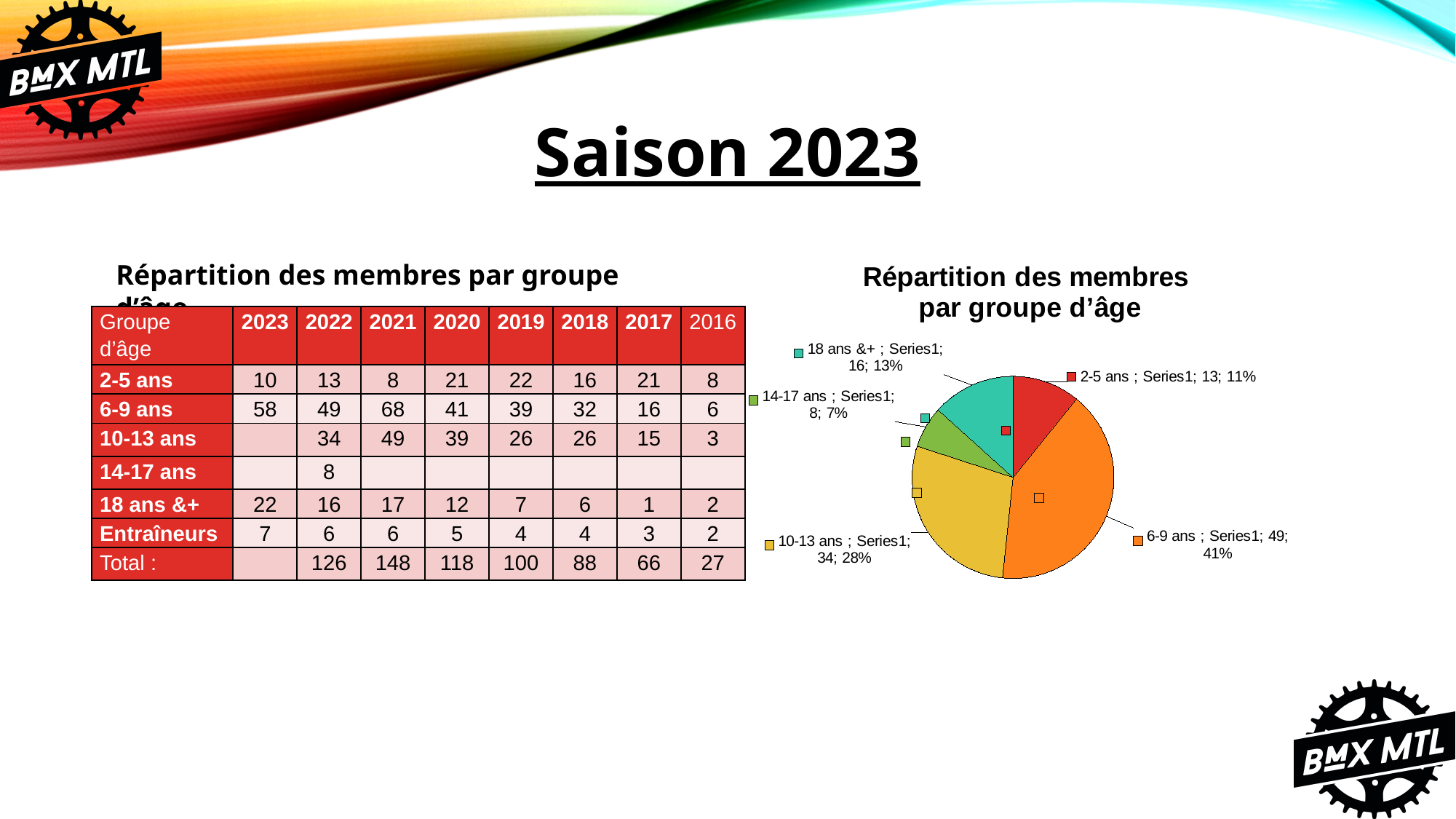
What share of the pie does 14-17 ans represent? 7% How many slices does the pie chart have? 5 Which is larger in the pie chart, 18 ans &+ or 2-5 ans? 18 ans &+ What is the value for 2-5 ans in the pie chart? 13 What is the value for 6-9 ans in the pie chart? 49 What is the difference between the values for 6-9 ans and 10-13 ans in the pie chart? 15 What is the value for 10-13 ans in the pie chart? 34 What is the title of the pie chart? Répartition des membres par groupe d’âge Which age group has the smallest slice in the pie chart? 14-17 ans Which age group has the largest slice in the pie chart? 6-9 ans What kind of chart is shown on the slide? pie chart What share of the pie does 18 ans &+ represent? 13%